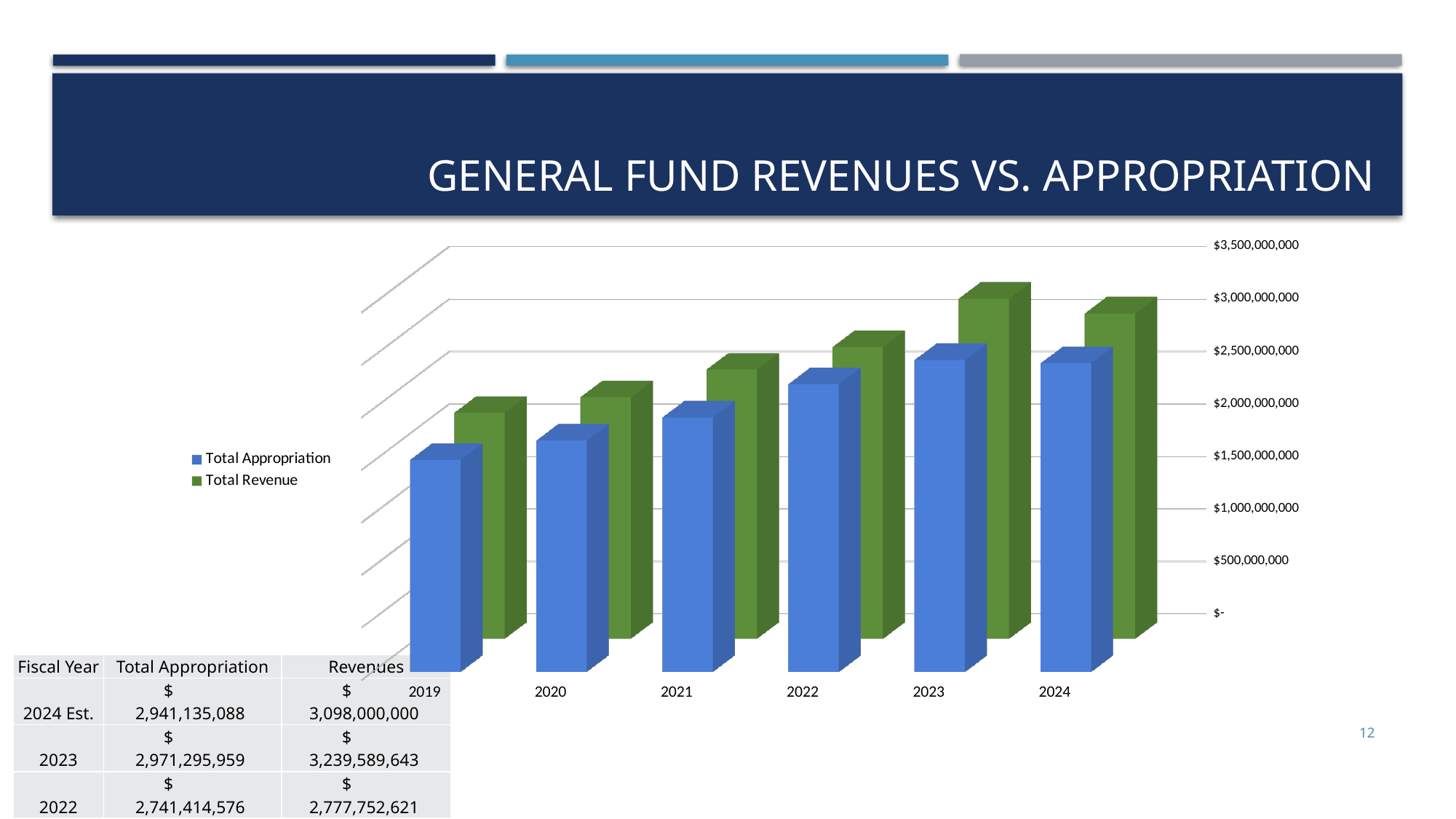
In 2023, which is larger, Total Appropriation or Total Revenue? Total Revenue What kind of chart is shown on the slide? bar chart Do the Total Appropriation bars generally rise or fall from 2019 to 2023? rise Which year has the highest Total Revenue bar? 2023 Which year has the lowest Total Appropriation bar? 2019 According to the table on the slide, what is the Total Appropriation for fiscal year 2023? $ 2,971,295,959 Is the Total Revenue value for 2019 greater or less than $2,500,000,000? less How many fiscal years are shown along the x axis of the chart? 6 According to the table on the slide, what are the Revenues for fiscal year 2022? $ 2,777,752,621 Is the Total Revenue value for 2023 greater or less than $2,500,000,000? greater How many series does the chart legend list? 2